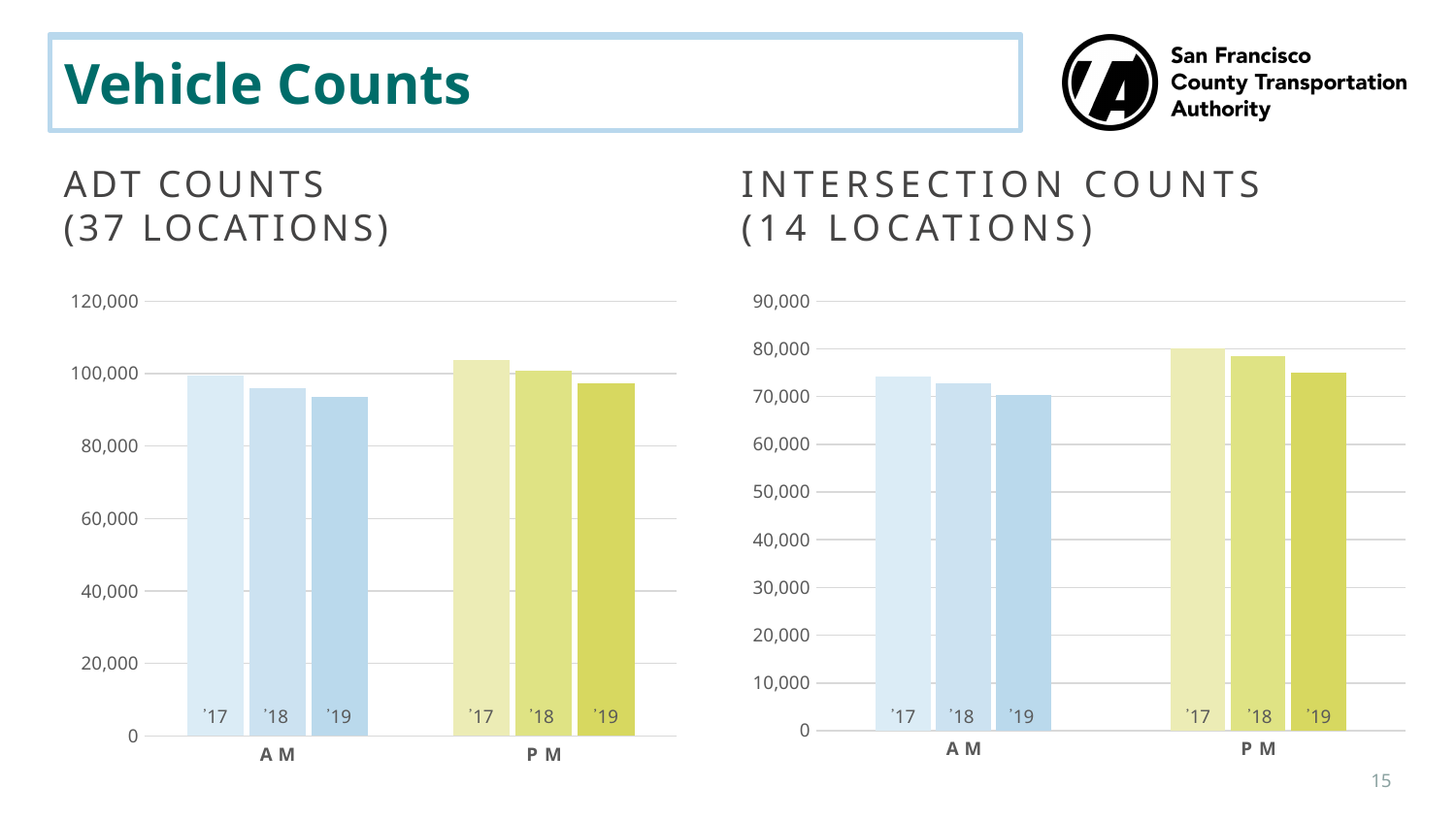
In the Intersection Counts chart, is the AM '17 value greater or less than 70,000? greater How many bars are plotted in the Intersection Counts (14 Locations) chart? 6 In the Intersection Counts chart, is the PM '19 value greater or less than 80,000? less In the ADT Counts chart, which bar is the tallest? PM '17 In the ADT Counts chart, which is larger: the AM '17 value or the PM '19 value? AM '17 What type of chart is the ADT Counts (37 Locations) chart? bar chart In the Intersection Counts chart, which bar is the shortest? AM '19 In the Intersection Counts chart, do the PM values rise or fall from '17 to '19? fall In the ADT Counts chart, is the PM '17 value greater or less than 100,000? greater In the ADT Counts chart, do the AM values rise or fall from '17 to '19? fall What are the two groups labelled on the x axis of the Intersection Counts chart? AM and PM